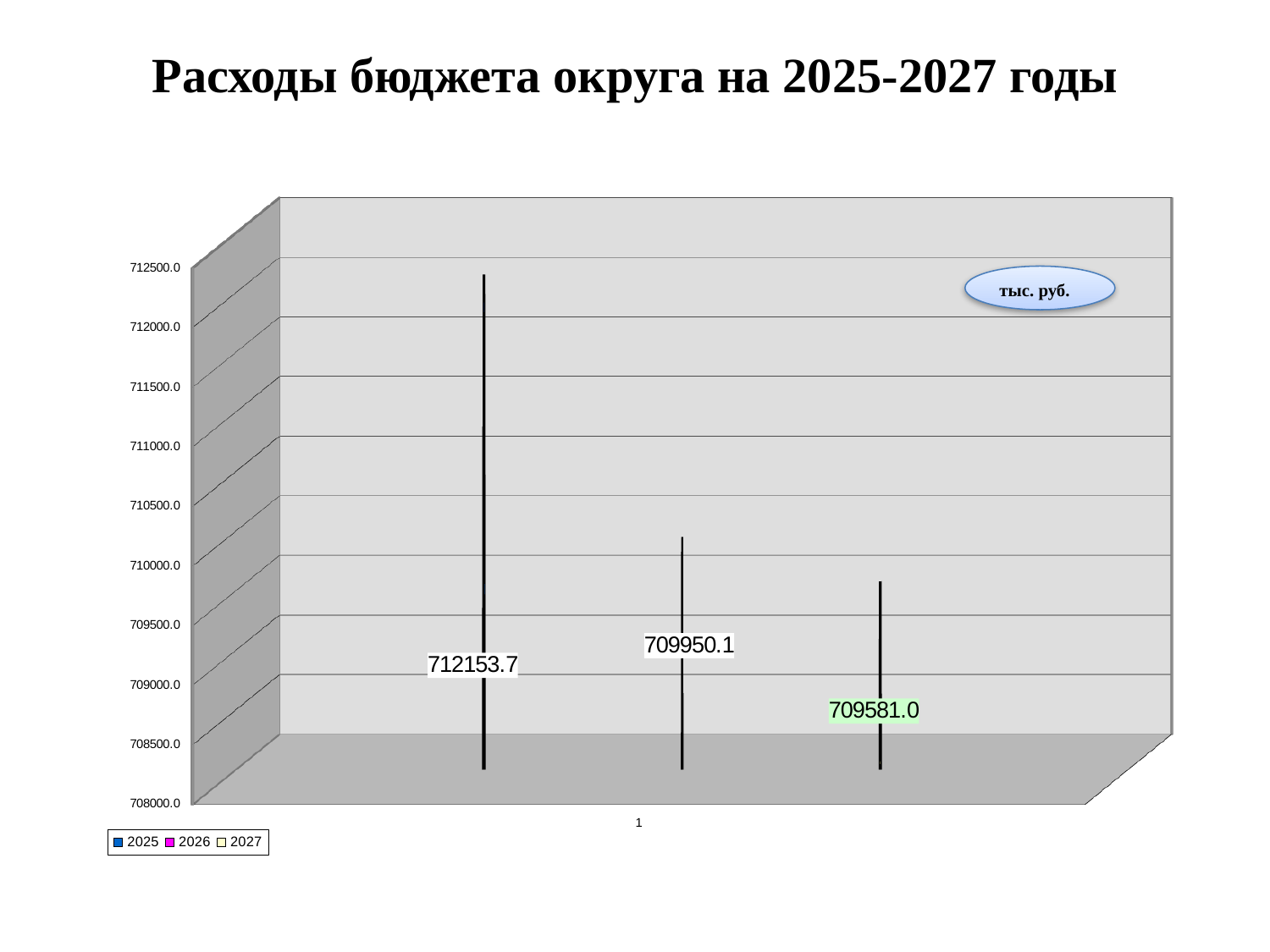
What is the difference between the 2026 value and the 2027 value? 369.1 What is the value for the 2026 series? 709950.1 What is the title of the chart? Расходы бюджета округа на 2025-2027 годы How many series does the legend list? 3 Is the value for 2026 greater or less than 710500.0? less What is the difference between the 2025 value and the 2026 value? 2203.6 Which series has the highest value? 2025 What is the value for the 2025 series? 712153.7 Which series has the lowest value? 2027 Which is larger, the value for 2025 or the value for 2027? 2025 What kind of chart is shown on the slide? bar chart What is the value for the 2027 series? 709581.0